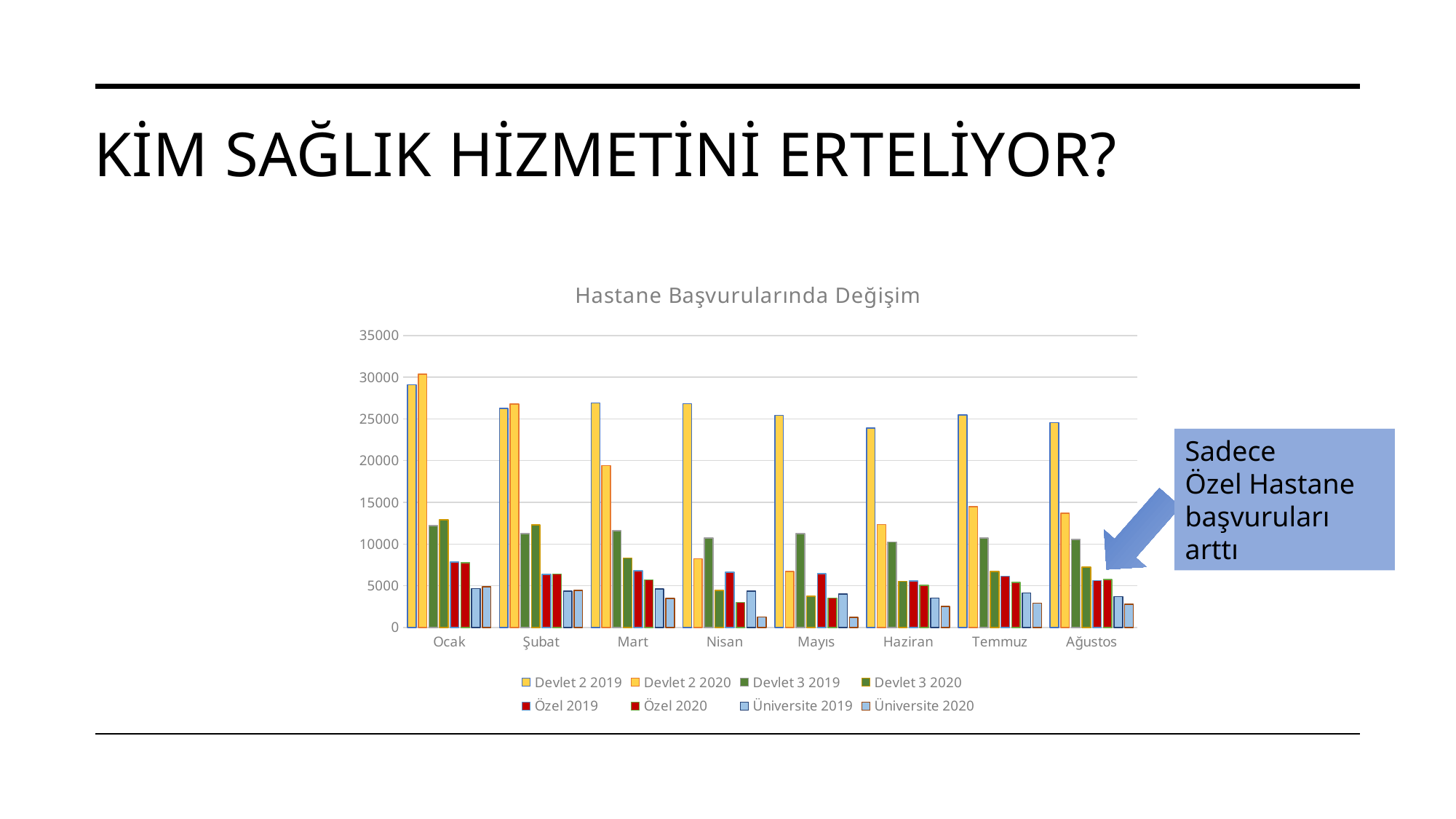
Does the Devlet 2 2020 series rise or fall from Ocak to Mayıs? fall How many series does the chart's legend list? 8 What is the title of the chart? Hastane Başvurularında Değişim In which month is the Devlet 2 2020 value lowest? Mayıs In which month is the Devlet 2 2020 value highest? Ocak Is the value for Üniversite 2020 in Nisan greater or less than 5000? less In Mart, which is larger: Devlet 2 2019 or Devlet 2 2020? Devlet 2 2019 How many months are shown on the x axis of the chart? 8 Is the value for Devlet 2 2020 in Nisan greater or less than 10000? less Is the value for Devlet 2 2019 in Ocak greater or less than 25000? greater What kind of chart is shown on the slide? Bar chart